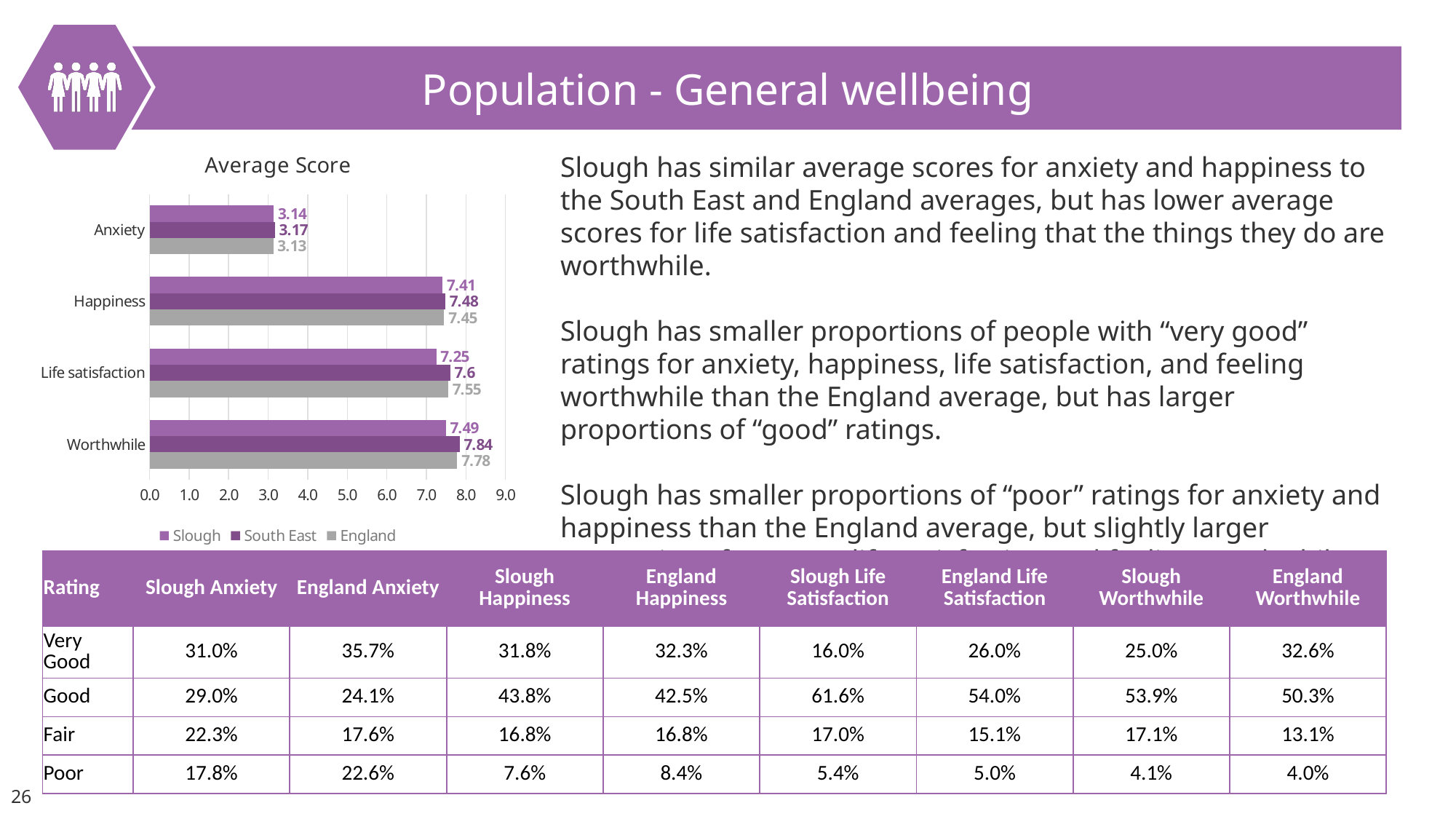
How many series does the legend of the Average Score chart list? 3 What is the South East average score for Worthwhile? 7.84 What is the title of the chart on the slide? Average Score Which category has the highest South East average score? Worthwhile Is the Slough average score for Happiness greater or less than 7.0? greater What is the difference between the South East and Slough average scores for Worthwhile? 0.35 How many categories are shown on the Average Score chart? 4 Which category has the lowest Slough average score? Anxiety Which is larger, the Slough or the England average score for Life satisfaction? England What is the England average score for Anxiety? 3.13 What is the Slough average score for Life satisfaction? 7.25 What kind of chart is the Average Score chart? Bar chart